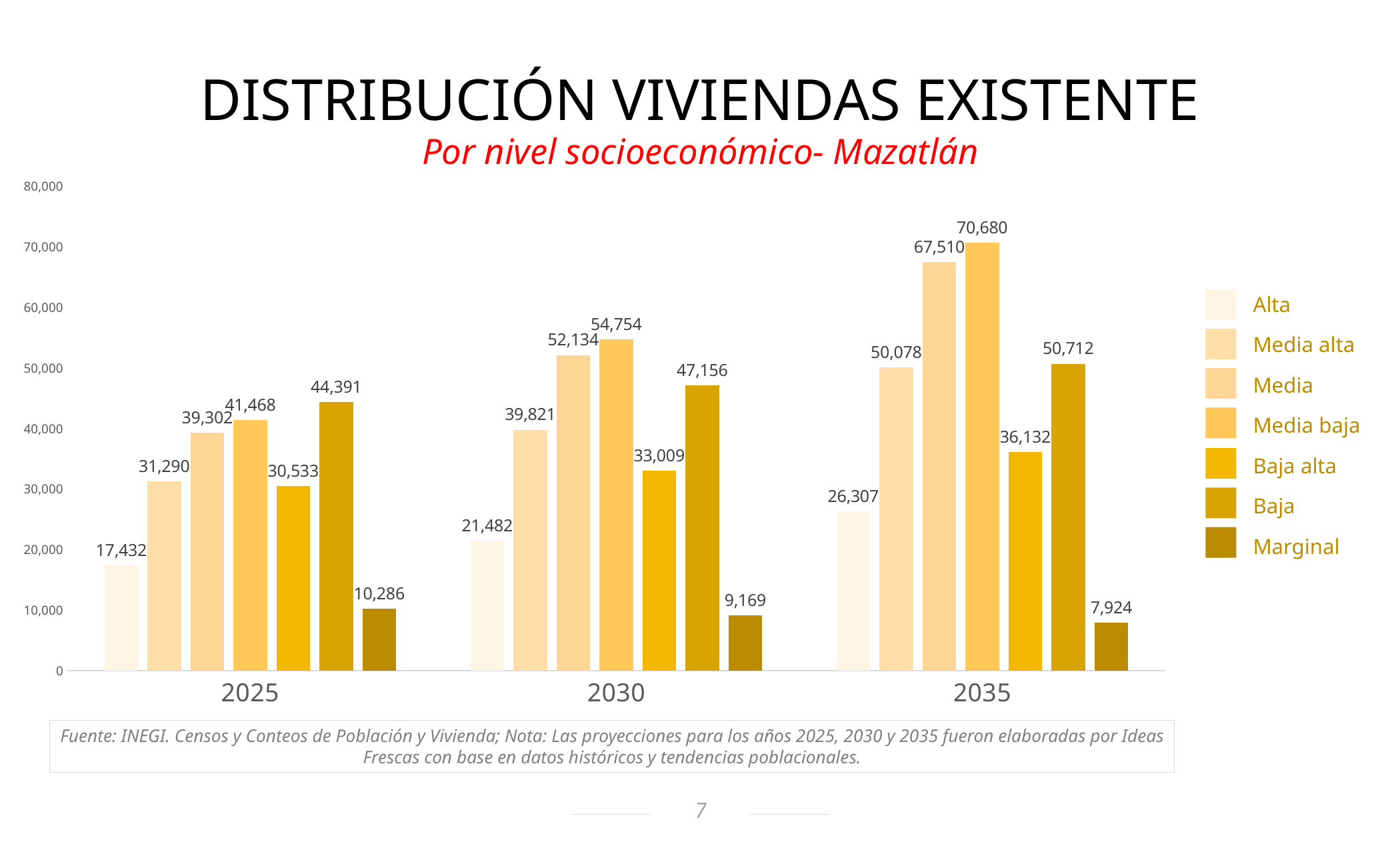
How many series does the legend list? 7 What is the value for Baja alta in 2030? 33,009 What is the value for Marginal in 2025? 10,286 Which is larger in 2035, Media alta or Baja? Baja Which series has the lowest value in 2035? Marginal How many year categories are shown on the x axis? 3 Do the Marginal values rise or fall from 2025 to 2035? Fall Which series has the highest value in 2025? Baja What is the difference between Baja and Baja alta in 2030? 14,147 What is the difference between the Media baja values for 2035 and 2025? 29,212 What kind of chart is shown on the slide? Bar chart What is the value for Media baja in 2035? 70,680